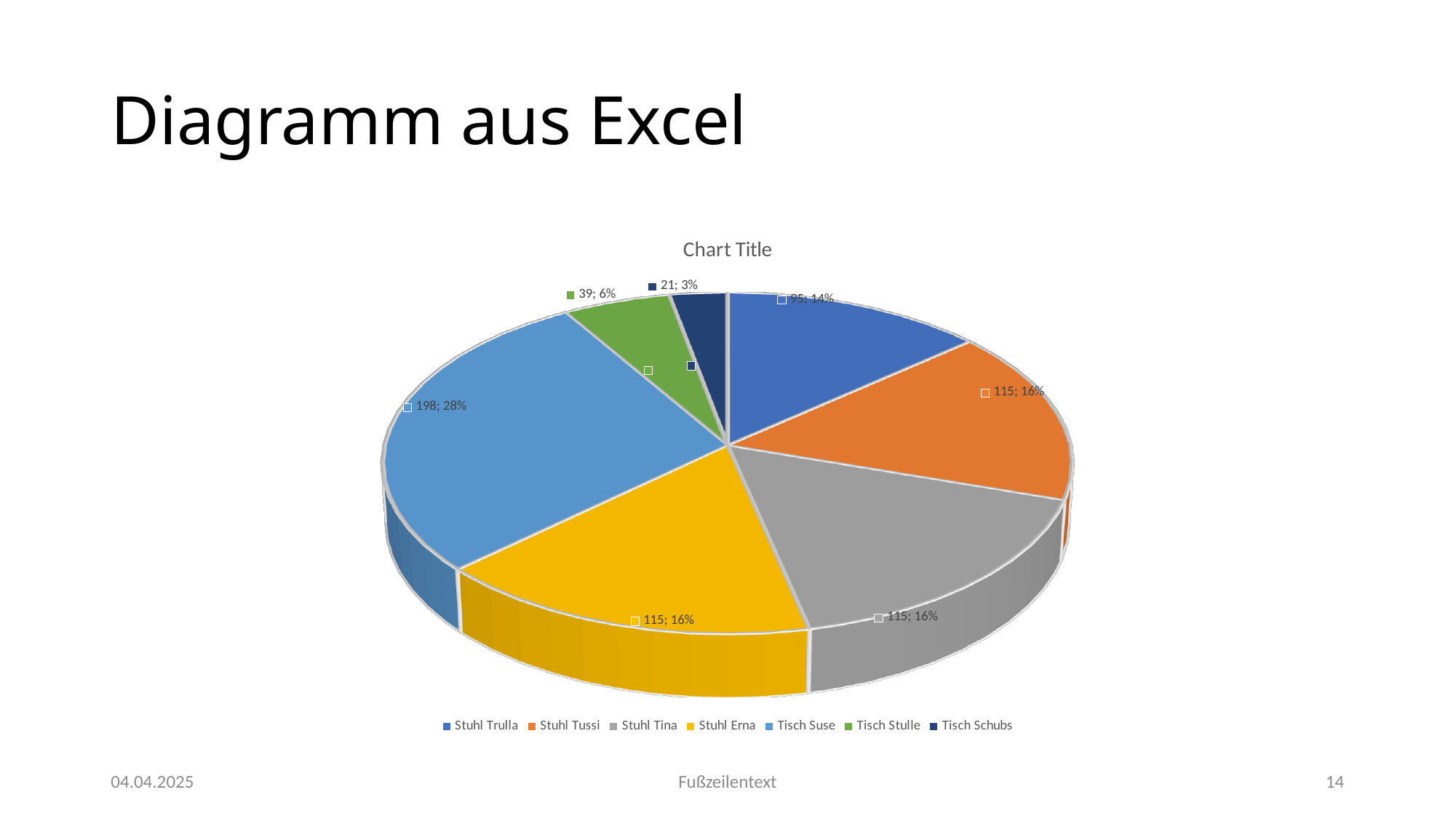
Which category has the largest slice? Tisch Suse Which is larger, the value for Tisch Stulle or the value for Tisch Schubs? Tisch Stulle What is the value for Tisch Suse? 198 What is the title of the chart? Chart Title How many slices does the pie chart have? 7 What is the value for Stuhl Trulla? 95 What kind of chart is shown on the slide? pie chart Which category has the smallest slice? Tisch Schubs What share of the pie does Tisch Stulle represent? 6% What is the difference between the values for Tisch Suse and Stuhl Trulla? 103 What is the value for Tisch Schubs? 21 What share of the pie does Tisch Suse represent? 28%